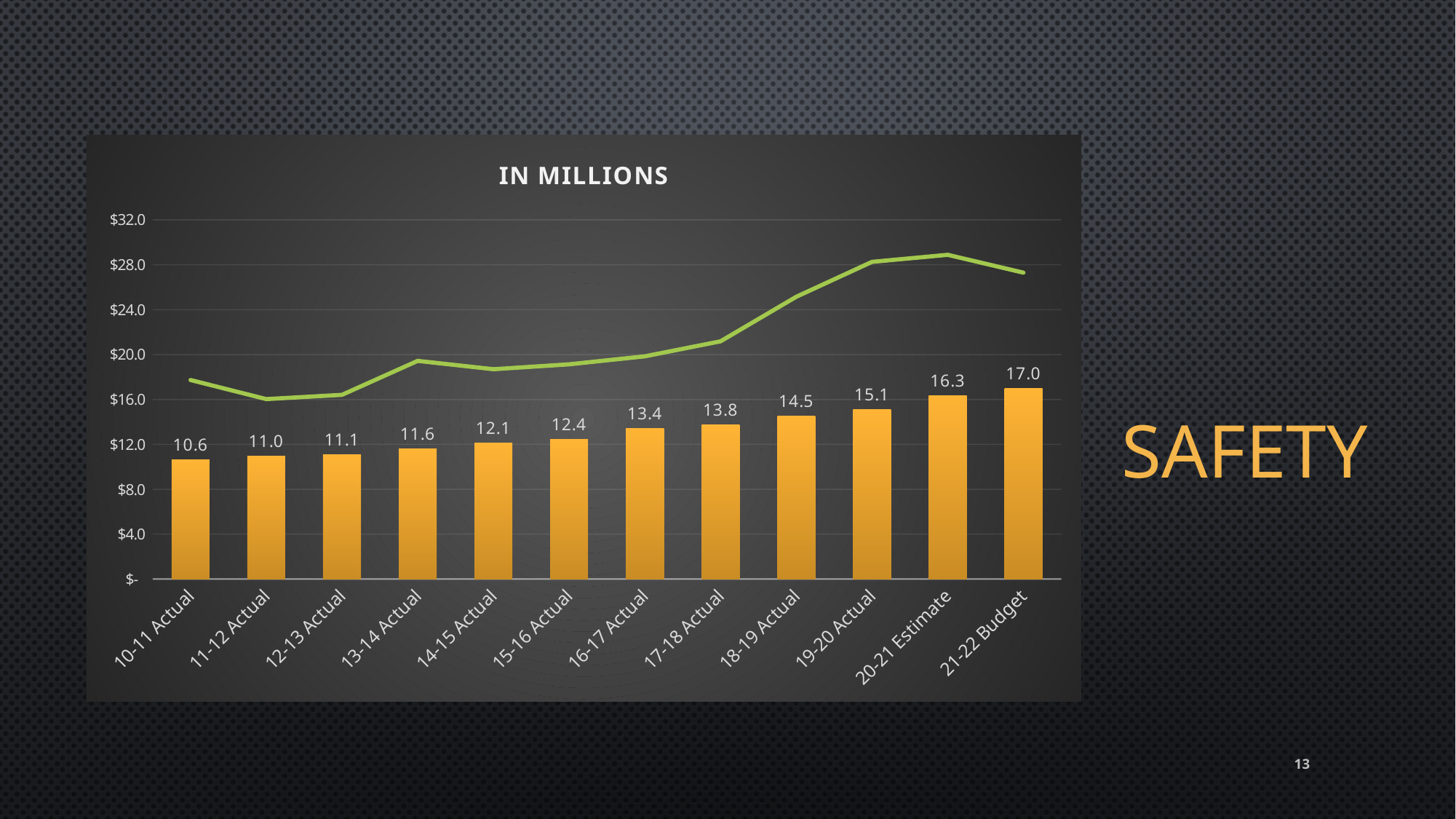
Which category has the lowest bar value? 10-11 Actual What is the title of the chart? IN MILLIONS Is the green line value for 20-21 Estimate greater or less than $28.0? greater Which has a larger bar value, 18-19 Actual or 19-20 Actual? 19-20 Actual Is the green line value for 11-12 Actual greater or less than $20.0? less What is the bar value for 21-22 Budget? 17.0 What is the bar value for 16-17 Actual? 13.4 How many categories are shown on the x axis? 12 Do the bar values rise or fall from 10-11 Actual to 21-22 Budget? rise Which category has the highest bar value? 21-22 Budget What is the bar value for 10-11 Actual? 10.6 What is the difference between the bar values for 21-22 Budget and 10-11 Actual? 6.4